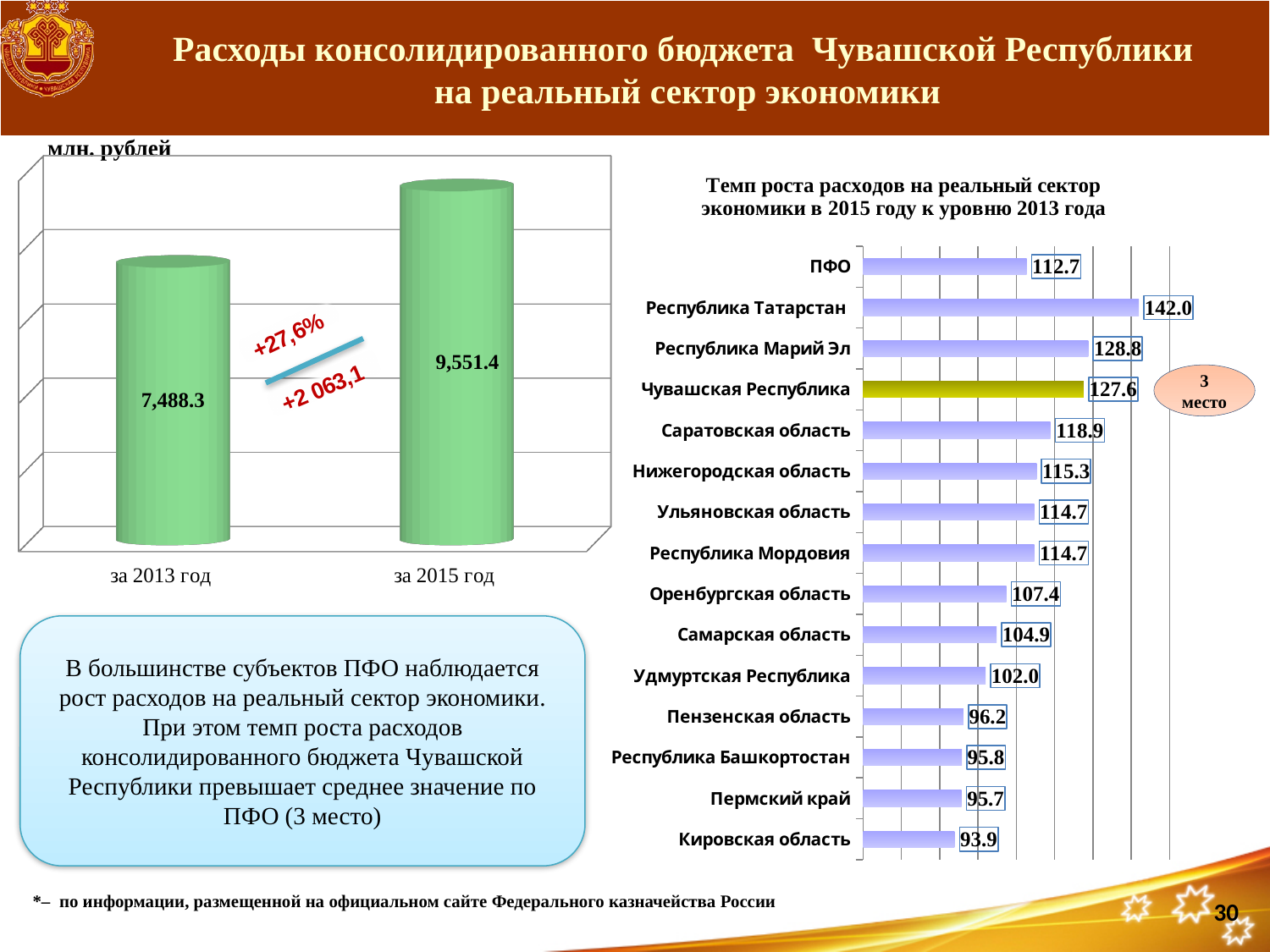
On the left chart, what is the value for 2015 (за 2015 год)? 9,551.4 On the left chart, what percentage growth is shown between 2013 and 2015? +27,6% On the right chart, which region has the lowest value? Кировская область On the right chart, which bar is highlighted in a different colour (yellow-green) from the others? Чувашская Республика On the right chart, which region has the highest value? Республика Татарстан On the left chart, what is the value for 2013 (за 2013 год)? 7,488.3 On the right chart, what is the difference between the values for Чувашская Республика and ПФО? 14.9 On the right chart (Темп роста расходов на реальный сектор экономики), what is the value for Чувашская Республика? 127.6 On the left chart, do the values rise or fall from 2013 to 2015? rise On the right chart, how many categories (bars) are shown? 15 On the right chart, which is larger: the value for Саратовская область or Нижегородская область? Саратовская область On the right chart, what is the value for ПФО? 112.7